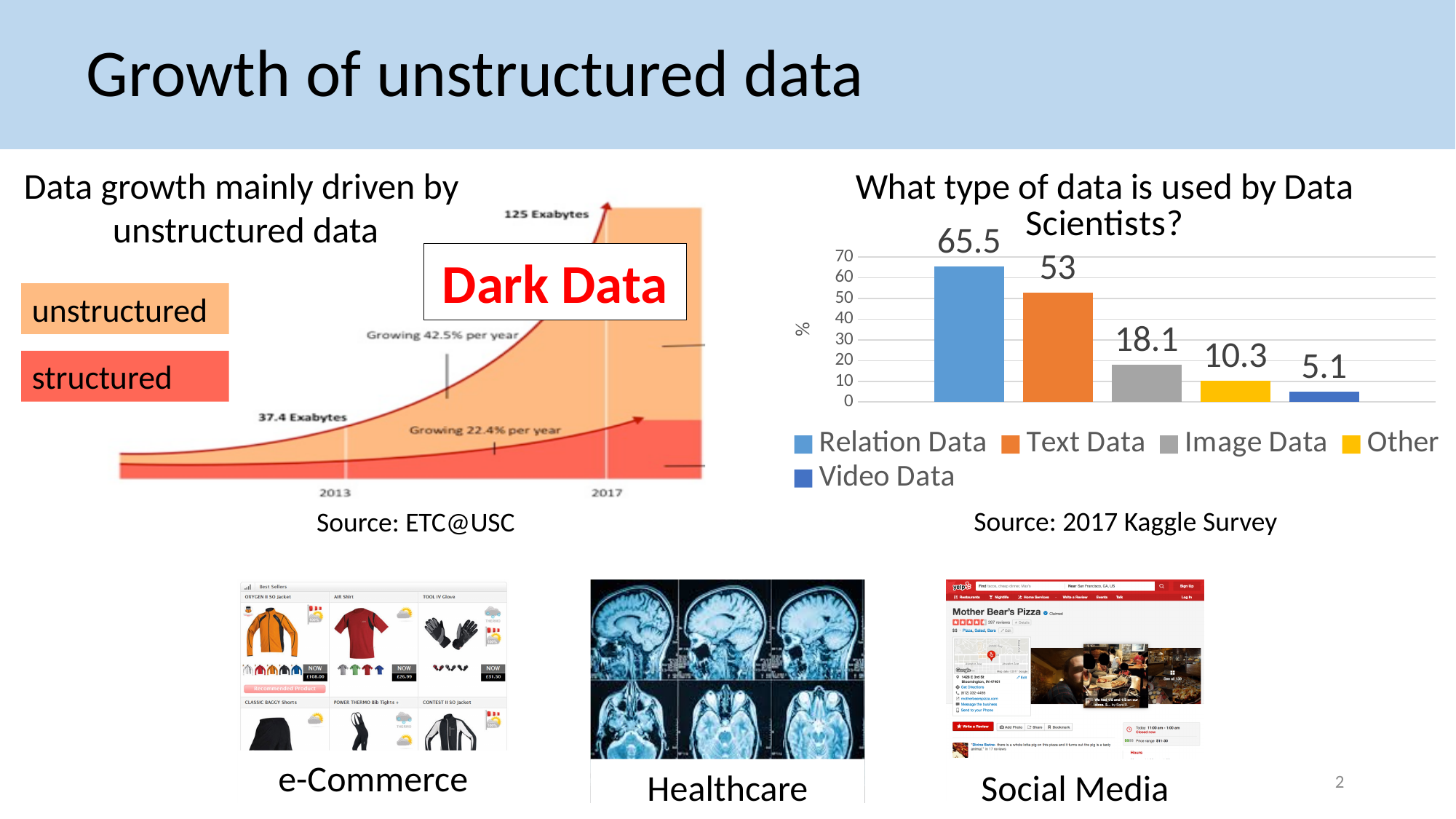
In the chart titled 'What type of data is used by Data Scientists?', what is the value for Text Data? 53 In the chart titled 'What type of data is used by Data Scientists?', how many series does the legend list? 5 In the chart titled 'What type of data is used by Data Scientists?', what is the difference between the values for Relation Data and Text Data? 12.5 In the chart on the left about data growth, what is the annual growth rate shown for unstructured data? 42.5% per year In the chart titled 'What type of data is used by Data Scientists?', what is the value for Video Data? 5.1 What kind of chart is the chart titled 'What type of data is used by Data Scientists?'? Bar chart In the chart on the left about data growth, what is the data volume labelled at the top of the curve? 125 Exabytes In the chart titled 'What type of data is used by Data Scientists?', what is the value for Image Data? 18.1 In the chart titled 'What type of data is used by Data Scientists?', which is larger: Image Data or Other? Image Data In the chart titled 'What type of data is used by Data Scientists?', what is the label on the vertical axis? % In the chart titled 'What type of data is used by Data Scientists?', which data type has the lowest value? Video Data In the chart titled 'What type of data is used by Data Scientists?', which data type has the highest value? Relation Data